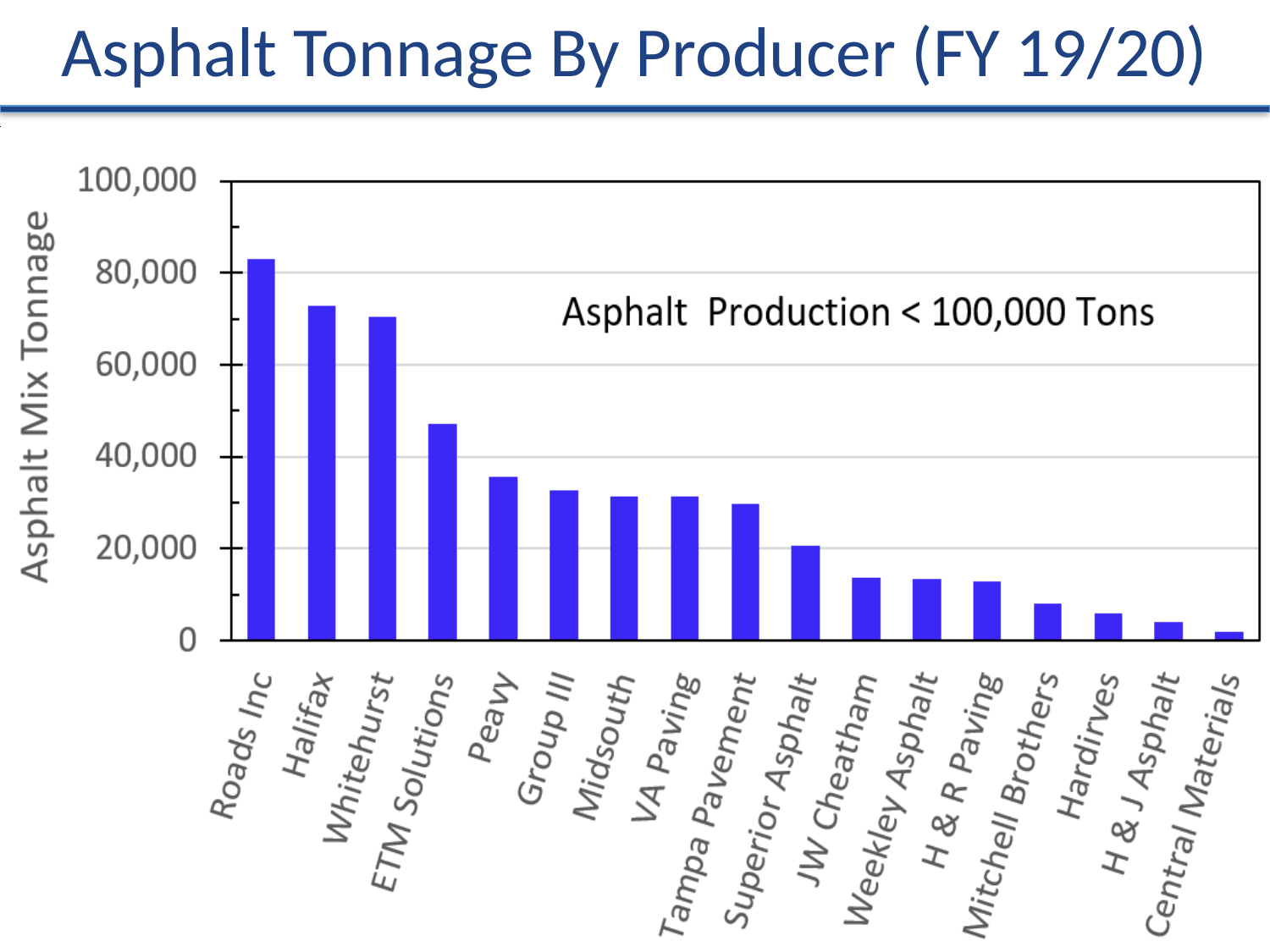
Is the value for Peavy greater or less than 40,000? less Is the value for Mitchell Brothers greater or less than 20,000? less Is the value for Halifax greater or less than 80,000? less Which producer has the highest asphalt mix tonnage? Roads Inc Do the values rise or fall moving from left to right along the x axis? fall What is the label on the y axis? Asphalt Mix Tonnage Which producer has the lowest asphalt mix tonnage? Central Materials What type of chart is shown on the slide? bar chart How many producers are shown on the x axis? 17 Which has the larger tonnage, ETM Solutions or Peavy? ETM Solutions